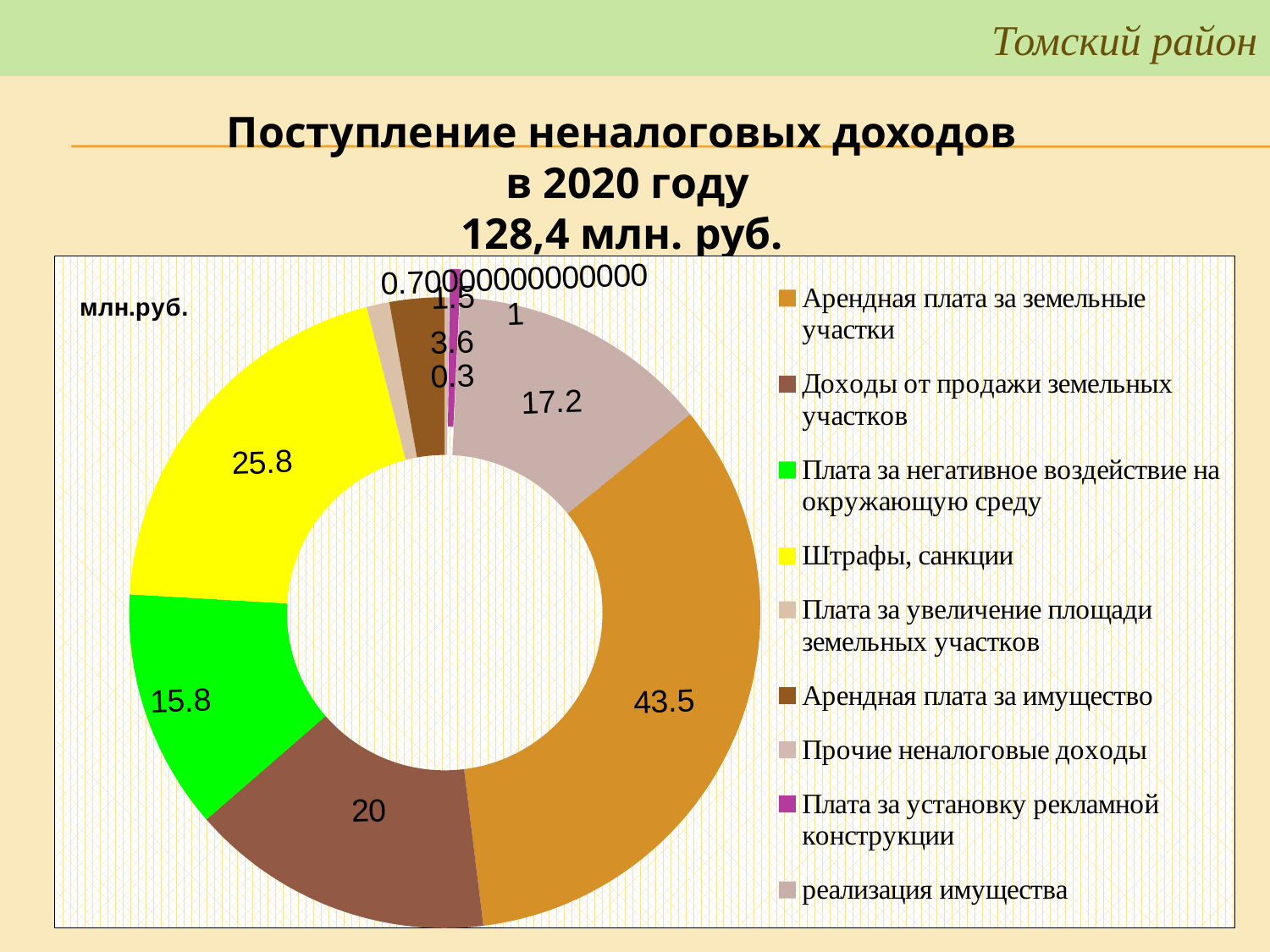
What kind of chart is shown on the slide? Doughnut (pie) chart What is the value for Арендная плата за земельные участки? 43.5 Which is larger: Штрафы, санкции or Доходы от продажи земельных участков? Штрафы, санкции What is the value for Штрафы, санкции? 25.8 What is the difference between Арендная плата за земельные участки and Доходы от продажи земельных участков? 23.5 What is the value for Прочие неналоговые доходы? 0.3 Which category has the largest share of the chart? Арендная плата за земельные участки How many entries does the legend list? 9 What is the value for Плата за негативное воздействие на окружающую среду? 15.8 What total amount of non-tax revenue in 2020 is stated in the chart title? 128,4 млн. руб. What is the value for Доходы от продажи земельных участков? 20 What is the difference between Штрафы, санкции and Плата за негативное воздействие на окружающую среду? 10